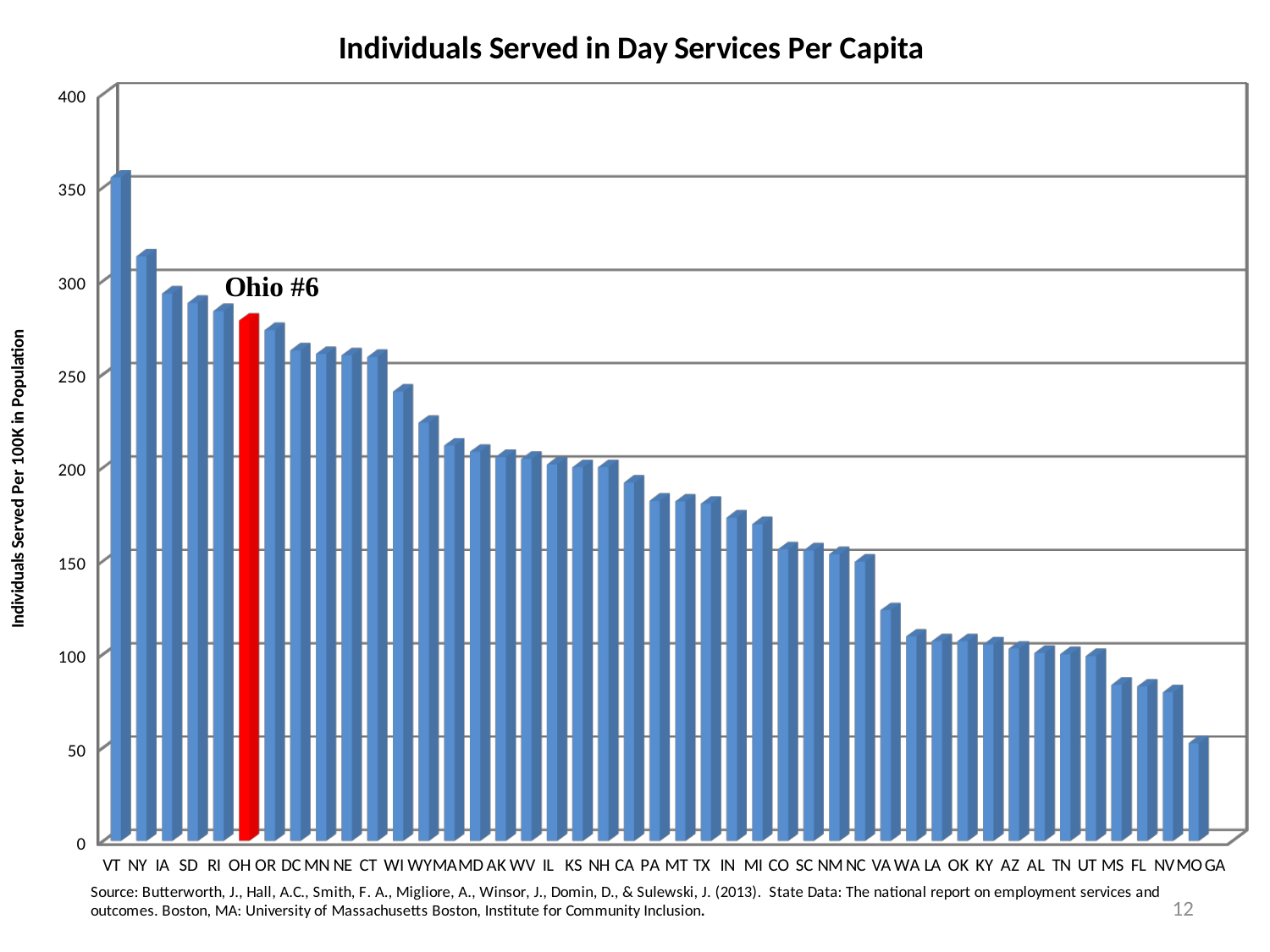
Which state has the lowest value for individuals served in day services per capita? MO Do the values rise or fall moving from left to right along the x axis? fall Is the value for WI greater or less than 250? less What kind of chart is shown on the slide? bar chart What is the title of the chart? Individuals Served in Day Services Per Capita Which has a larger value, NY or CA? NY Which has a larger value, VA or MO? VA Which state has the highest value for individuals served in day services per capita? VT Is the value for VT greater or less than 350? greater Which state's bar is highlighted in red, and what rank is annotated for it? OH, Ohio #6 Is the value for OH greater or less than 250? greater